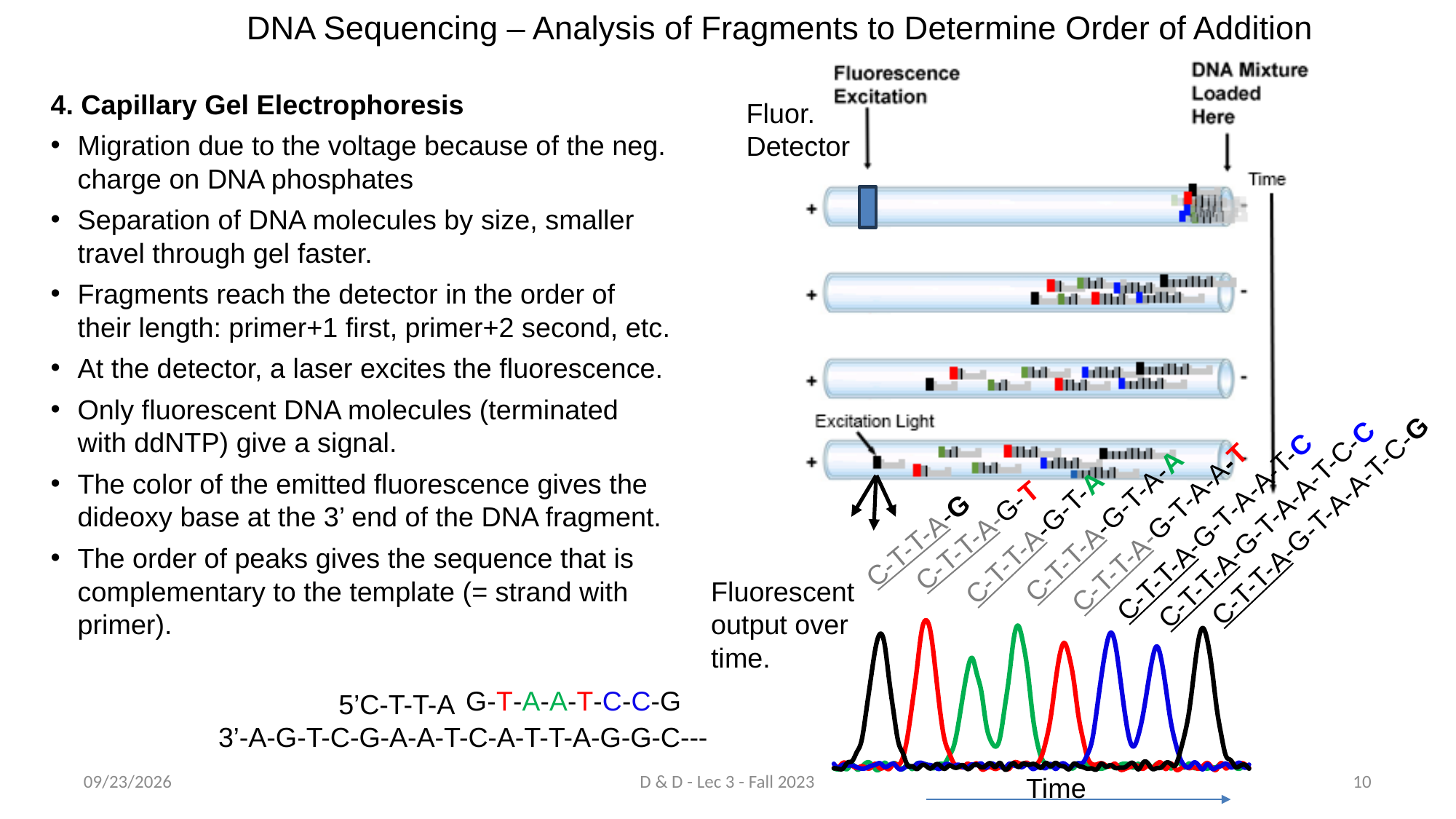
How many blue peaks are there in the fluorescent output over time chart? 2 How many peaks are shown in the fluorescent output over time chart? 8 What colour is the last peak (latest in time) in the fluorescent output chart? black What colour is the first peak (earliest in time) in the fluorescent output chart? black How many different colours of peaks appear in the fluorescent output over time chart? 4 What kind of chart is the 'Fluorescent output over time' plot at the bottom right of the slide? line chart In the fluorescent output chart, what colour are the two peaks that immediately follow the second red peak? blue What is the label on the horizontal axis of the fluorescent output chart? Time According to the slide, what base sequence do the peaks in the fluorescent output chart correspond to, in order of time? G-T-A-A-T-C-C-G